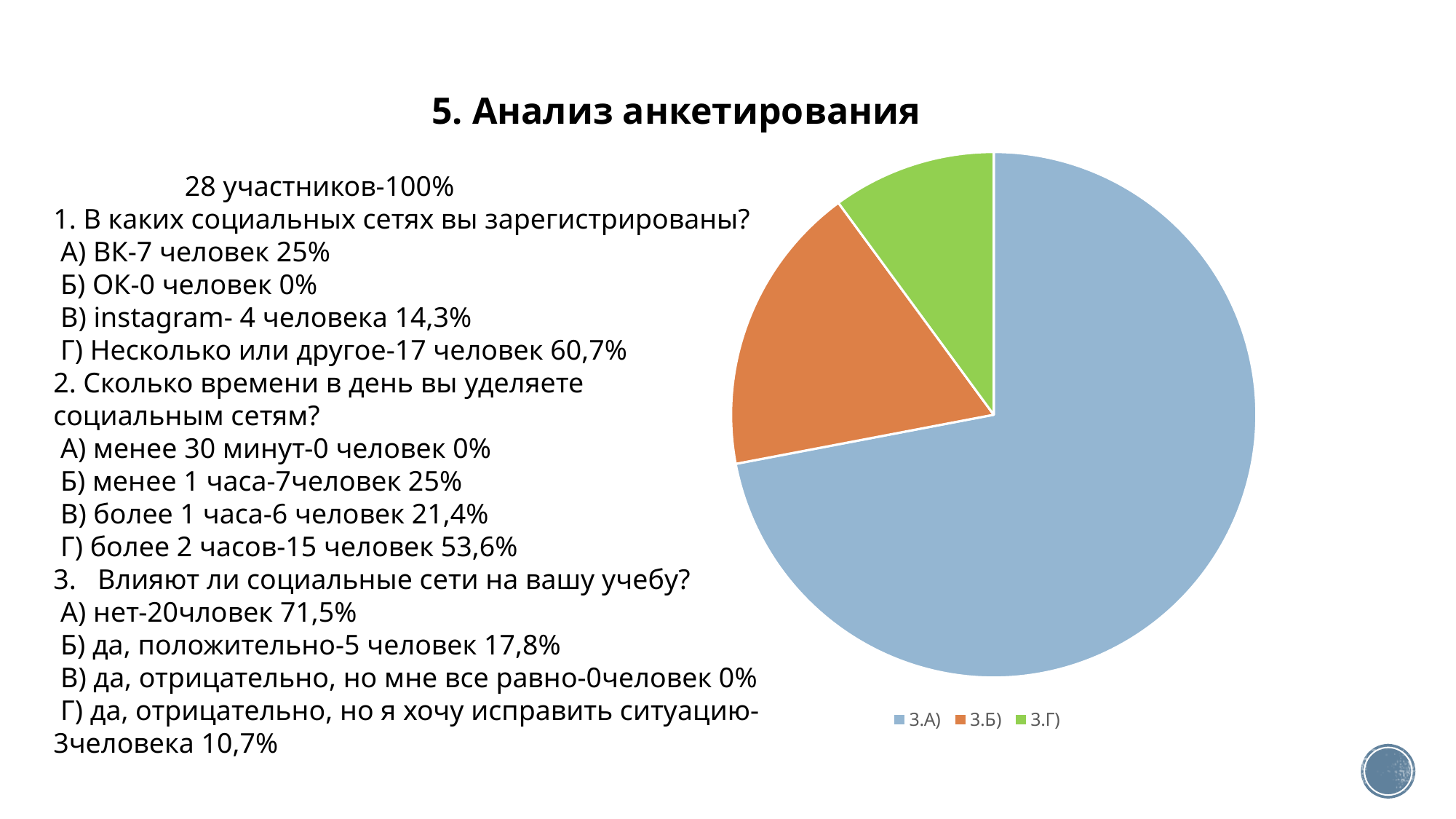
How many entries does the legend of the pie chart list? 3 Does the slice for 3.А) take up more or less than half of the pie? more What kind of chart is shown on the slide? pie chart Which category has the largest slice in the pie chart? 3.А) Which category is shown in green in the pie chart? 3.Г) Which category has the smallest slice in the pie chart? 3.Г) What colour is the slice for 3.А) in the pie chart? blue Which slice is larger in the pie chart, 3.Б) or 3.Г)? 3.Б) How many slices does the pie chart have? 3 Which slice is larger in the pie chart, 3.А) or 3.Б)? 3.А)